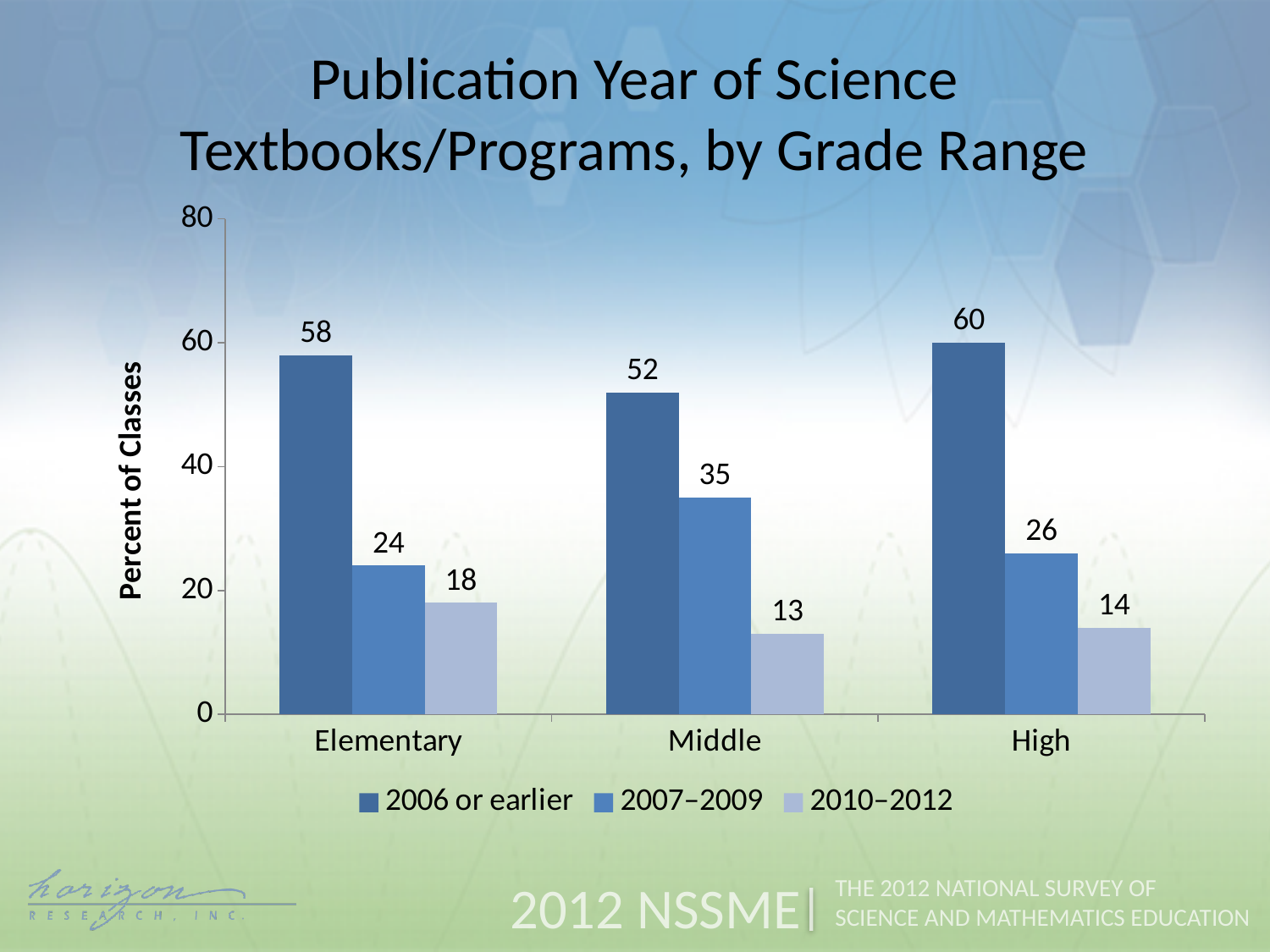
Which grade range has the highest value for 2006 or earlier? High What kind of chart is shown on the slide? Bar chart Which grade range has the lowest value for 2010–2012? Middle Which is larger: the 2007–2009 value for Middle or the 2007–2009 value for Elementary? Middle What is the title of the chart? Publication Year of Science Textbooks/Programs, by Grade Range How many grade range categories are shown on the x axis? 3 What is the value for 2007–2009 in the Middle category? 35 What is the label of the y axis? Percent of Classes What is the value for 2006 or earlier in the Elementary category? 58 What is the difference between the 2006 or earlier and 2007–2009 values for High? 34 What is the value for 2010–2012 in the High category? 14 How many series does the legend list? 3